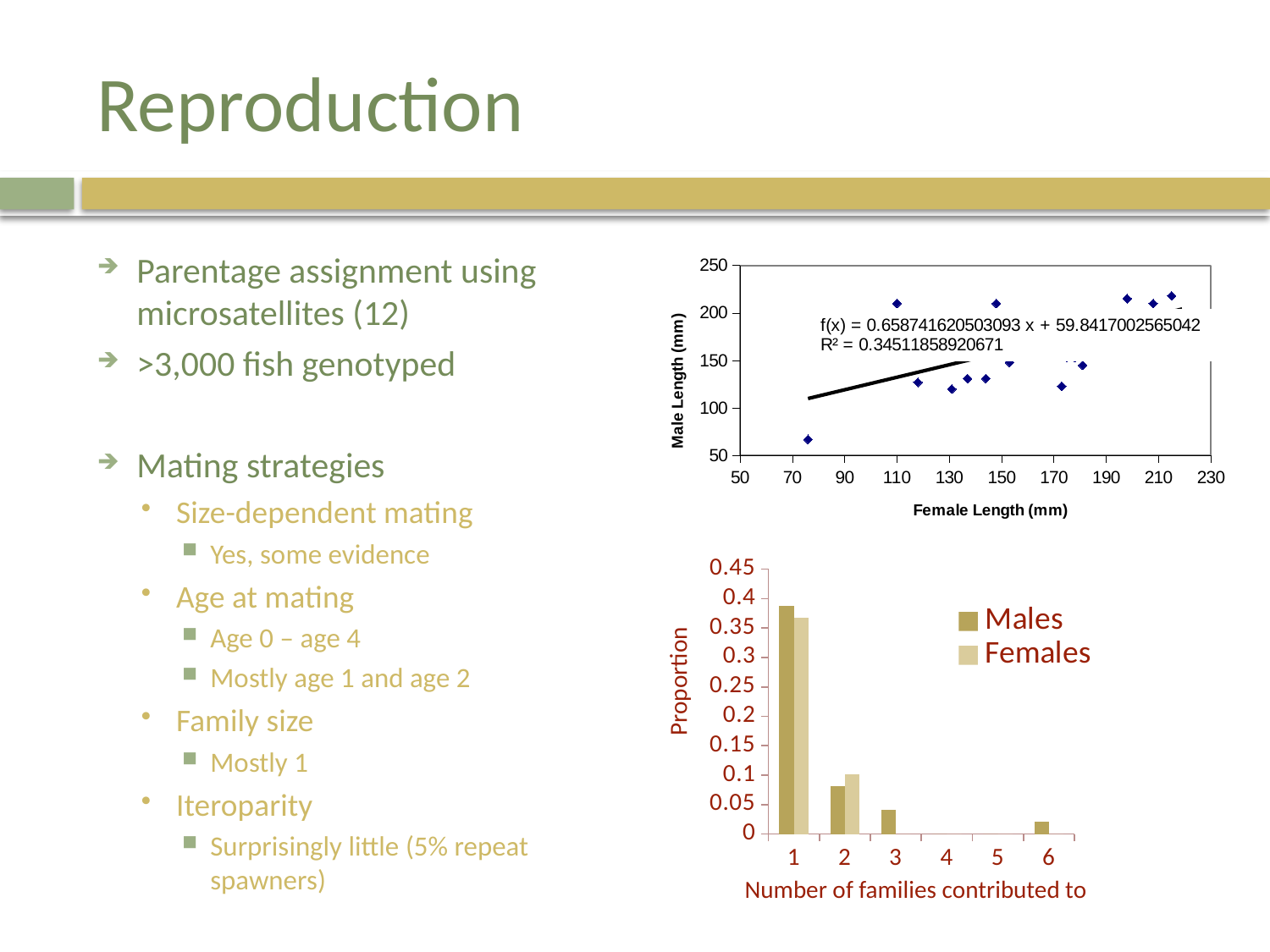
In the bottom bar chart, which series has the larger value for 2 families, Males or Females? Females In the top scatter plot, what R² value is printed for the trendline? R² = 0.34511858920671 In the bottom bar chart, do the Males values rise or fall from 1 family to 3 families? fall What kind of chart is the bottom chart on the slide (Proportion vs Number of families contributed to)? bar chart In the bottom bar chart, how many series does the legend list? 2 In the bottom bar chart, which number of families has the highest Males proportion? 1 In the bottom bar chart, is the Females value for 2 families greater or less than 0.15? less In the bottom bar chart, how many categories are shown on the x axis? 6 In the bottom bar chart, which series has the larger value for 1 family, Males or Females? Males In the bottom bar chart, is the Males value for 1 family greater or less than 0.35? greater In the bottom bar chart, what are the two series named in the legend? Males and Females What kind of chart is the top chart on the slide (Male Length vs Female Length)? scatter plot